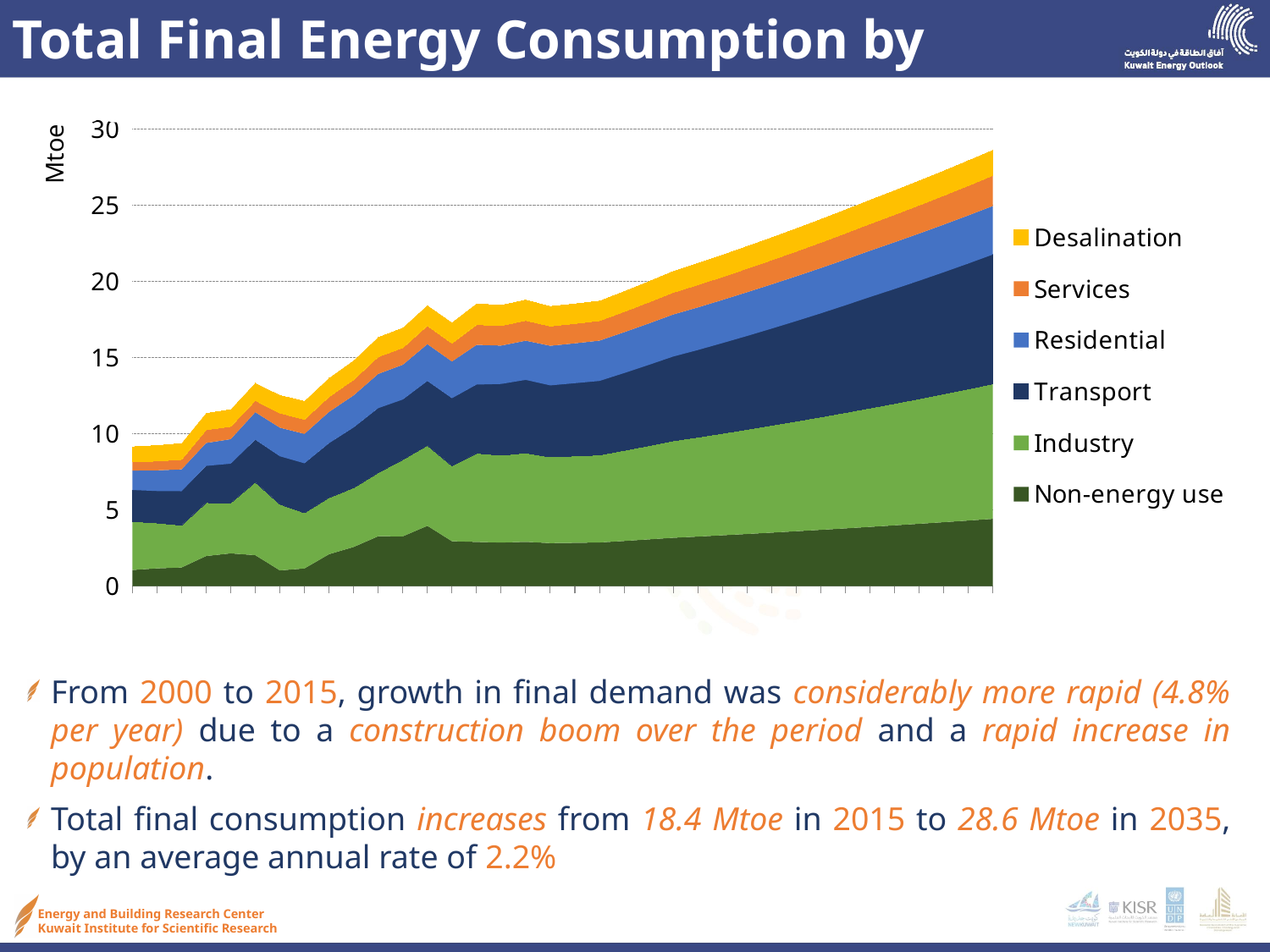
What kind of chart is shown on the slide? Stacked area chart Which series is shown in yellow in the chart? Desalination Is the total stacked value at the right end of the chart greater or less than 30? less Is the total stacked value at the right end of the chart greater or less than 25? greater At the right end of the chart, which series has the thinnest band? Desalination At the right end of the chart, which band is thicker: Industry or Services? Industry What unit is shown on the chart's vertical axis? Mtoe Which series occupies the bottom layer of the stacked area chart? Non-energy use Does the total final energy consumption in the chart rise or fall from left to right? Rise How many series does the chart's legend list? 6 Is the top of the Non-energy use area at the right end of the chart greater or less than 10? less